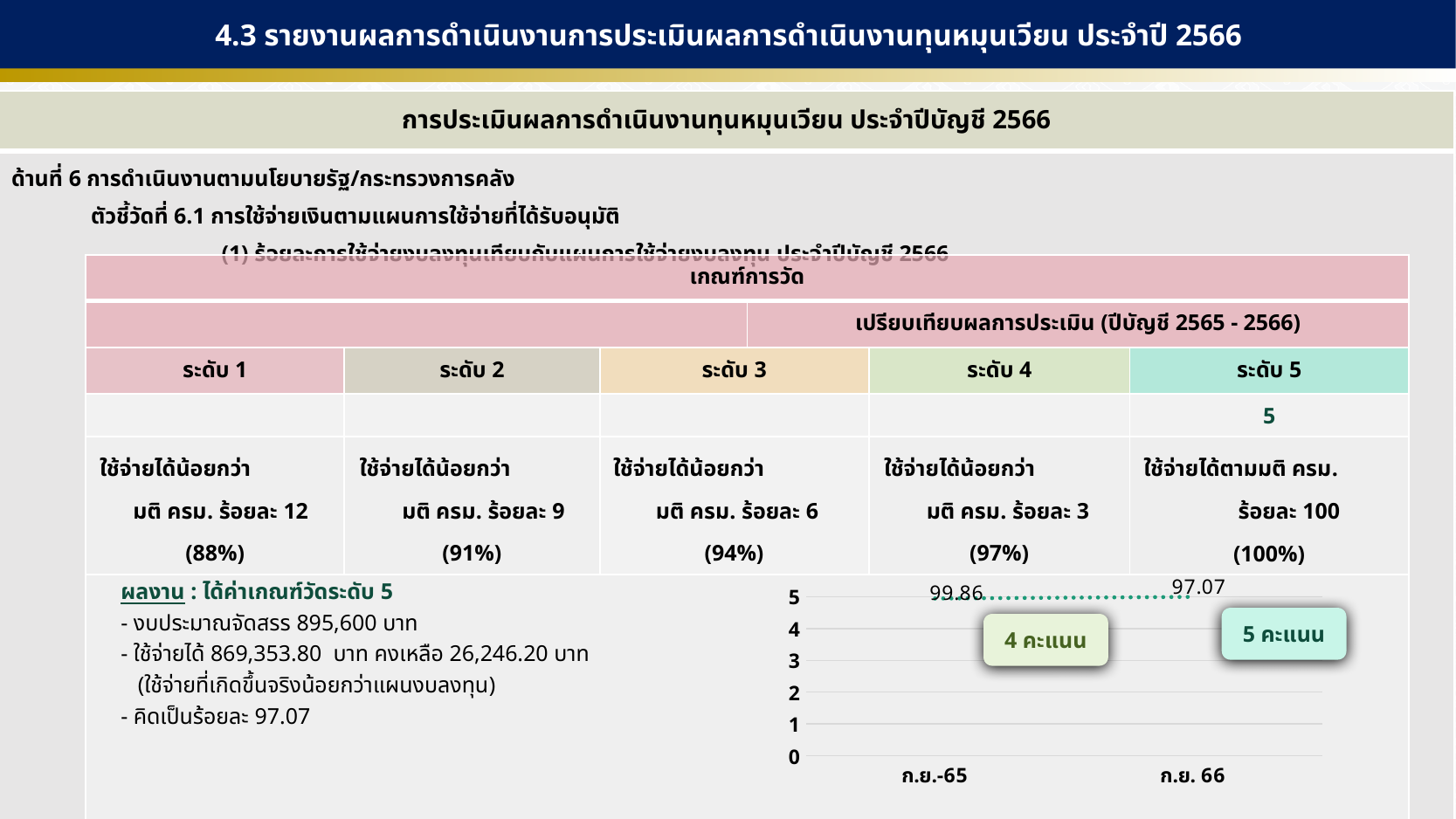
How many data points are plotted in the chart? 2 Which category has the highest data label in the chart? ก.ย.-65 What score is shown in the callout box above ก.ย. 66 in the chart? 5 คะแนน What is the data label shown for ก.ย.-65 in the chart? 99.86 What type of chart is shown at the bottom right of the slide? line chart What is the highest tick value shown on the chart's vertical axis? 5 Do the data labels in the chart rise or fall from ก.ย.-65 to ก.ย. 66? fall Which category has the higher data label in the chart, ก.ย.-65 or ก.ย. 66? ก.ย.-65 Which category has the lowest data label in the chart? ก.ย. 66 What is the difference between the data labels for ก.ย.-65 and ก.ย. 66 in the chart? 2.79 What is the data label shown for ก.ย. 66 in the chart? 97.07